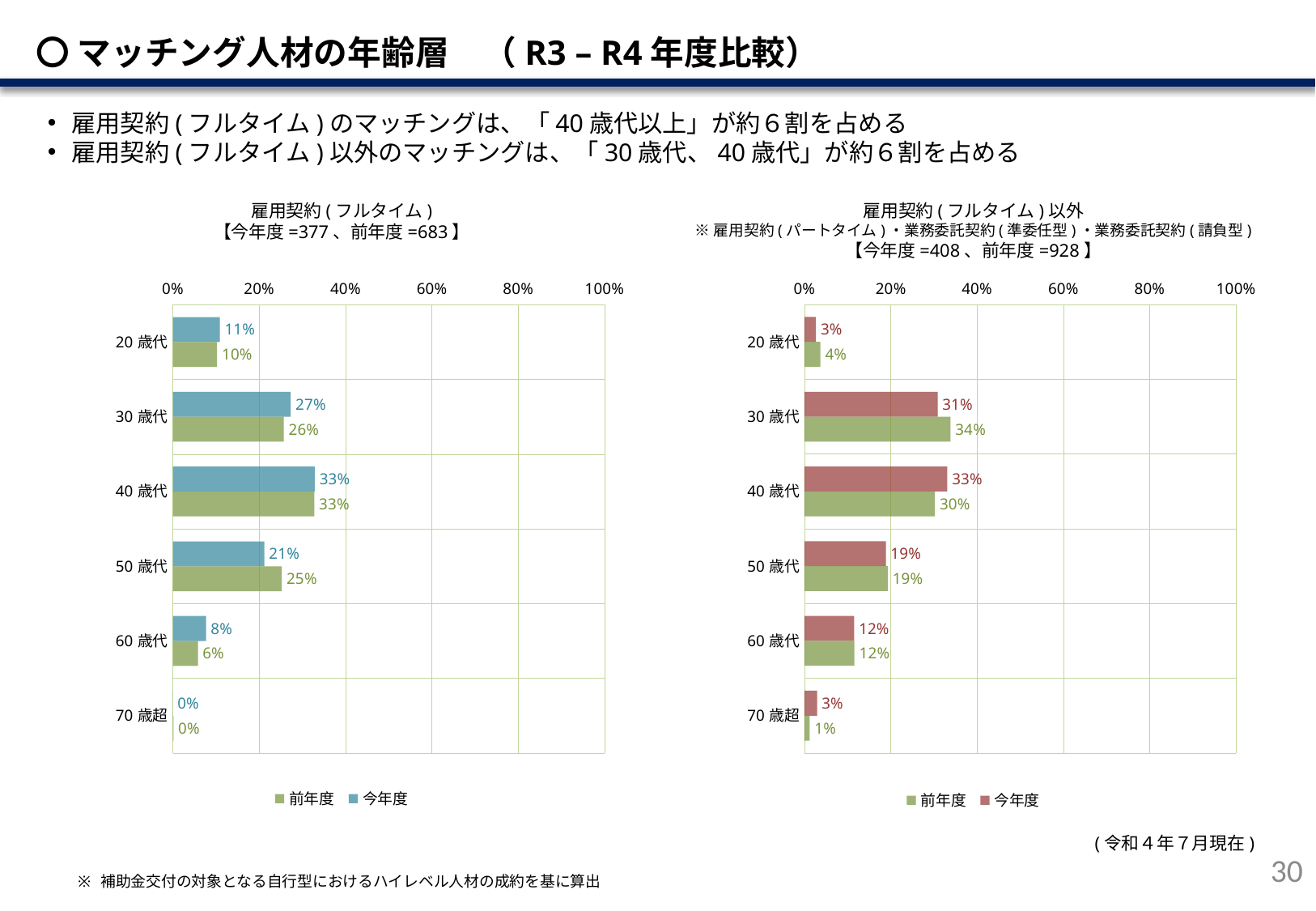
In the right chart (雇用契約(フルタイム)以外), what is the 今年度 value for 70歳超? 3% In the left chart (雇用契約(フルタイム)), what is the difference between the 前年度 and 今年度 values for 50歳代? 4% In the right chart (雇用契約(フルタイム)以外), what is the 前年度 value for 30歳代? 34% What type of chart is the left chart (雇用契約(フルタイム))? Bar chart In the left chart (雇用契約(フルタイム)), what is the 前年度 value for 50歳代? 25% In the left chart (雇用契約(フルタイム)), what is the 今年度 value for 30歳代? 27% How many series does the legend of the right chart (雇用契約(フルタイム)以外) list? 2 In the left chart (雇用契約(フルタイム)), which age group has the highest 今年度 value? 40歳代 In the right chart (雇用契約(フルタイム)以外), which age group has the lowest 前年度 value? 70歳超 In the right chart (雇用契約(フルタイム)以外), which is larger for 40歳代, the 今年度 value or the 前年度 value? 今年度 How many age categories are shown in the left chart (雇用契約(フルタイム))? 6 In the right chart (雇用契約(フルタイム)以外), is the 今年度 value for 30歳代 greater or less than 20%? greater